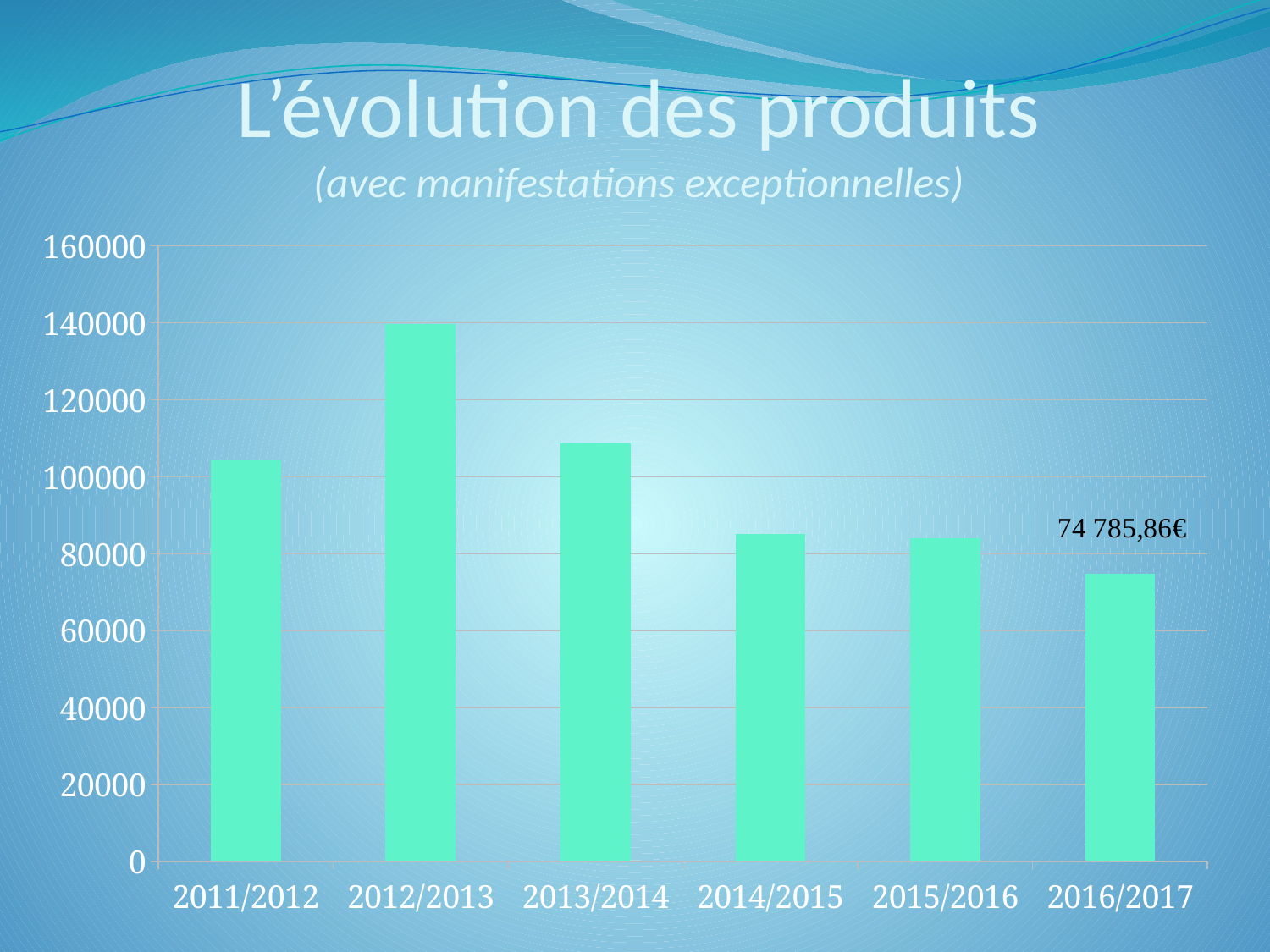
Is the value for 2011/2012 greater or less than 100000? greater What value is labelled on the bar for 2016/2017? 74 785,86€ Which year has the lowest value? 2016/2017 Is the value for 2012/2013 greater or less than 120000? greater Which is larger, the value for 2011/2012 or the value for 2014/2015? 2011/2012 Is the value for 2014/2015 greater or less than 80000? greater How many years are shown on the x axis? 6 What is the title of the chart on the slide? L'évolution des produits (avec manifestations exceptionnelles) Do the values rise or fall from 2012/2013 to 2016/2017? fall What kind of chart is shown on the slide? Bar chart Which year has the highest value? 2012/2013